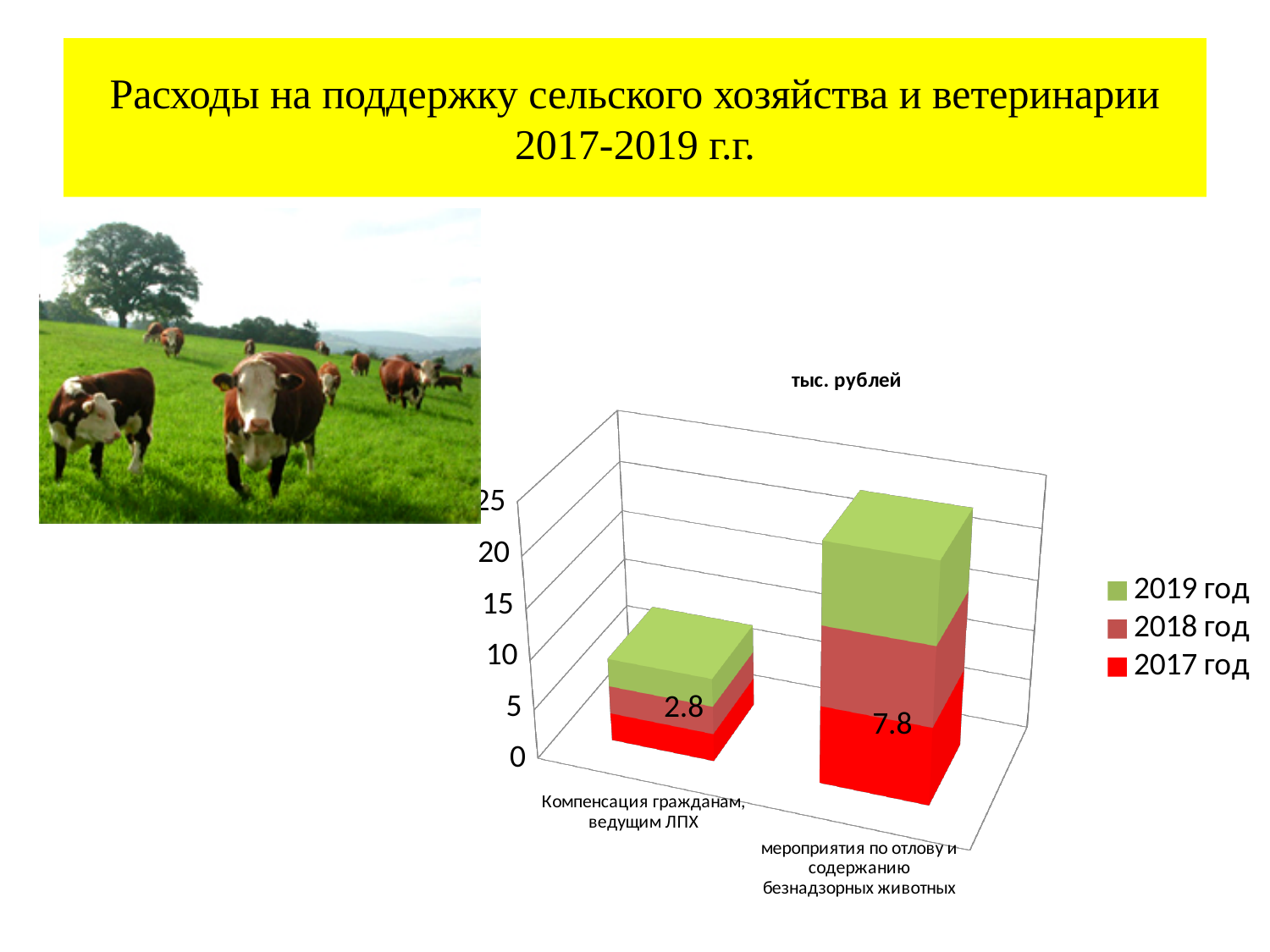
Which category has the larger 2017 год value: 'Компенсация гражданам, ведущим ЛПХ' or 'мероприятия по отлову и содержанию безнадзорных животных'? мероприятия по отлову и содержанию безнадзорных животных How many series does the legend list? 3 What unit is given in the chart title? тыс. рублей Which category has the shortest stacked bar overall? Компенсация гражданам, ведущим ЛПХ What is the value for 2017 год for the category 'мероприятия по отлову и содержанию безнадзорных животных'? 7.8 Which category has the tallest stacked bar overall? мероприятия по отлову и содержанию безнадзорных животных How many categories are shown on the chart? 2 Is the total stacked value for 'Компенсация гражданам, ведущим ЛПХ' greater or less than 15? less What is the difference between the 2017 год values for 'мероприятия по отлову и содержанию безнадзорных животных' and 'Компенсация гражданам, ведущим ЛПХ'? 5 What is the value for 2017 год for the category 'Компенсация гражданам, ведущим ЛПХ'? 2.8 What kind of chart is shown on the slide? Stacked bar chart Is the total stacked value for 'мероприятия по отлову и содержанию безнадзорных животных' greater or less than 15? greater